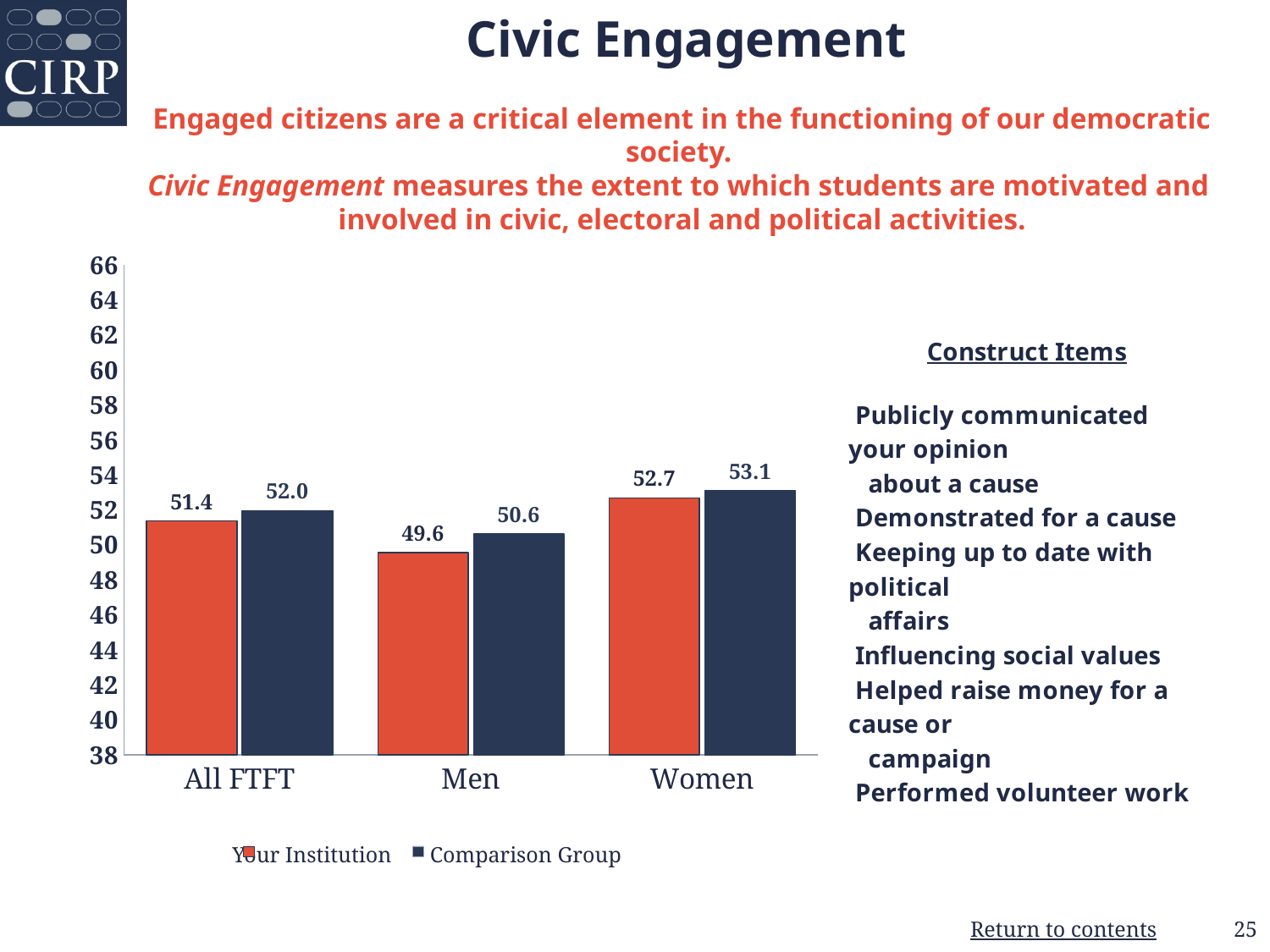
Which category has the highest Comparison Group value? Women Is the Your Institution value for Men greater or less than 50? less What is the Your Institution value for Men? 49.6 What kind of chart is shown on the slide? bar chart For Men, which is larger: Your Institution or Comparison Group? Comparison Group What is the difference between the Comparison Group and Your Institution values for All FTFT? 0.6 What is the Comparison Group value for Women? 53.1 Which category has the lowest Your Institution value? Men How many series does the legend list? 2 What is the Your Institution value for All FTFT? 51.4 What is the difference between the Your Institution values for Women and Men? 3.1 How many categories are shown on the x axis? 3